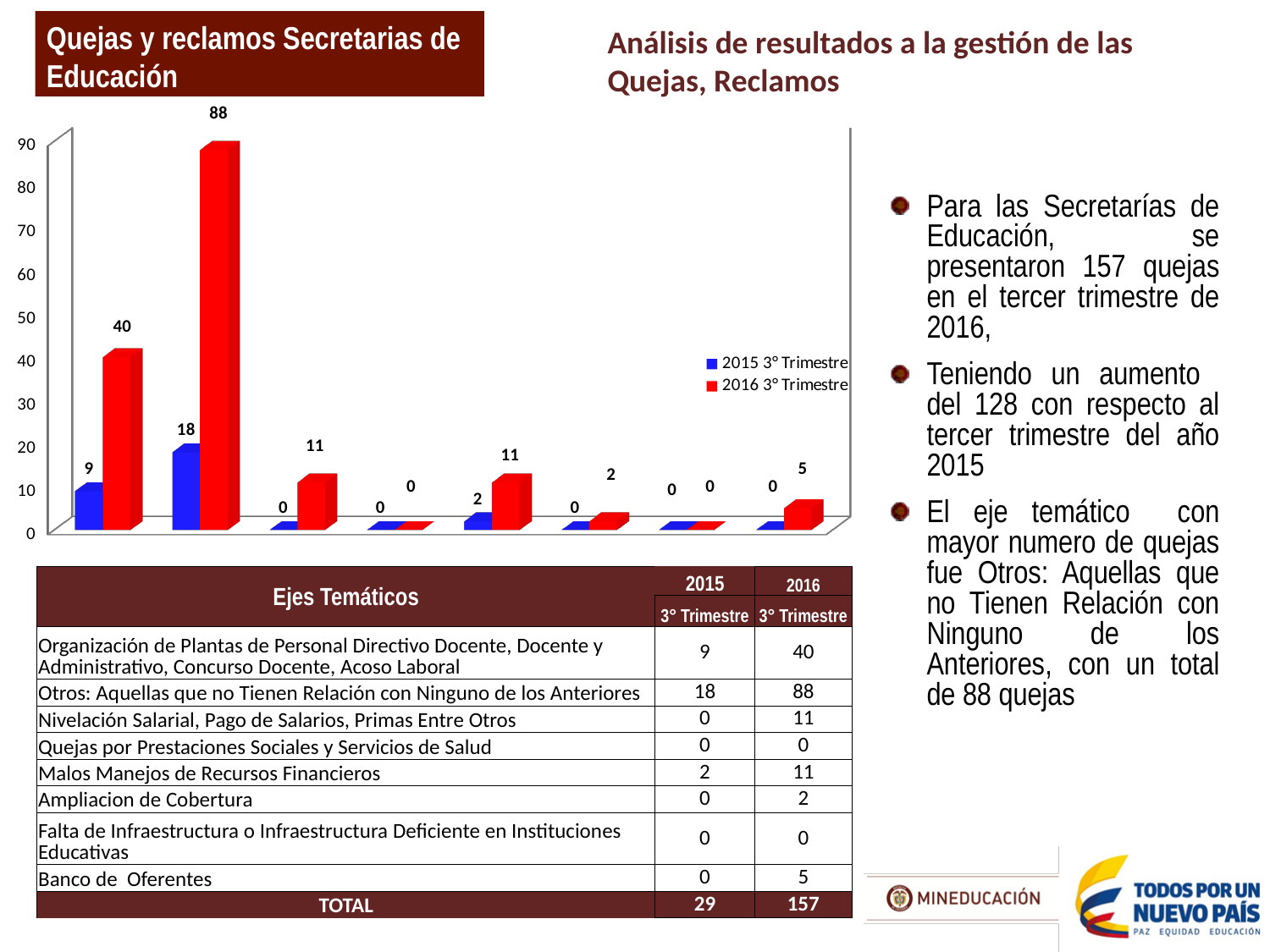
What type of chart is shown on the slide? bar chart What is the 2016 3° Trimestre value for the first group of bars in the chart? 40 In the fifth group of bars, which series has the larger value, 2015 3° Trimestre or 2016 3° Trimestre? 2016 3° Trimestre What is the 2016 3° Trimestre value for the last group of bars in the chart? 5 How many groups of bars (categories) are plotted in the chart? 8 What are the two series named in the chart legend? 2015 3° Trimestre and 2016 3° Trimestre What is the title of the chart on the slide? Quejas y reclamos Secretarias de Educación What is the 2015 3° Trimestre value for the first group of bars in the chart? 9 What is the highest value shown for the 2016 3° Trimestre series in the chart? 88 What is the difference between the 2016 3° Trimestre and 2015 3° Trimestre values in the second group of bars (88 and 18)? 70 What is the highest value shown for the 2015 3° Trimestre series in the chart? 18 How many series does the chart legend list? 2